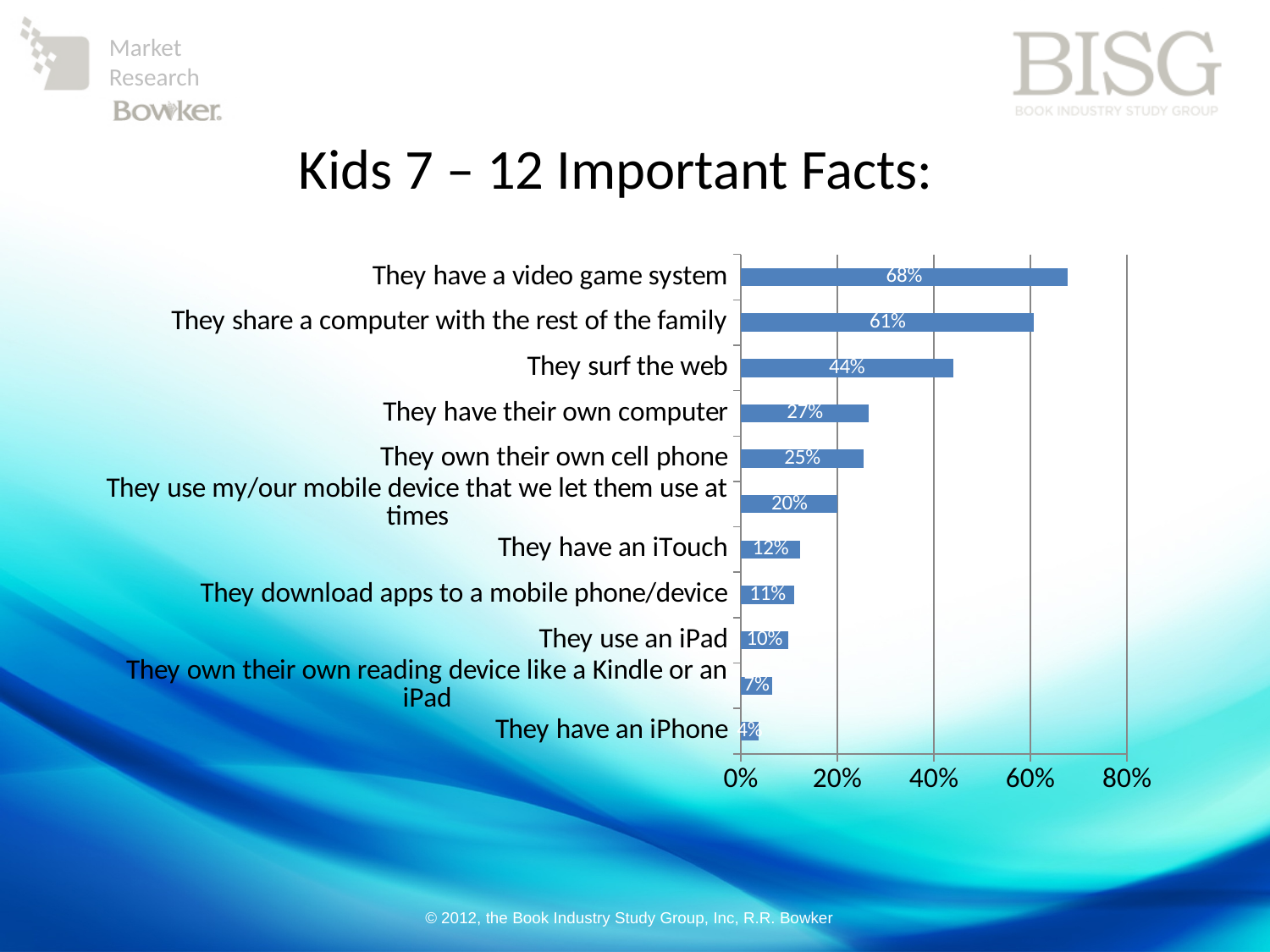
What is the title of the slide containing the chart? Kids 7 – 12 Important Facts: Is the value for 'They share a computer with the rest of the family' greater or less than 40%? greater How many categories are shown in the chart? 11 What percentage of kids 7–12 have a video game system? 68% What percentage of kids 7–12 share a computer with the rest of the family? 61% Which category has the highest value in the chart? They have a video game system What percentage of kids 7–12 use an iPad? 10% What kind of chart is shown on the slide? Bar chart What is the difference between the percentage who surf the web and the percentage who have their own computer? 17% What percentage of kids 7–12 own their own cell phone? 25% Which is larger: the percentage who have an iTouch or the percentage who download apps to a mobile phone/device? They have an iTouch Which category has the lowest value in the chart? They have an iPhone